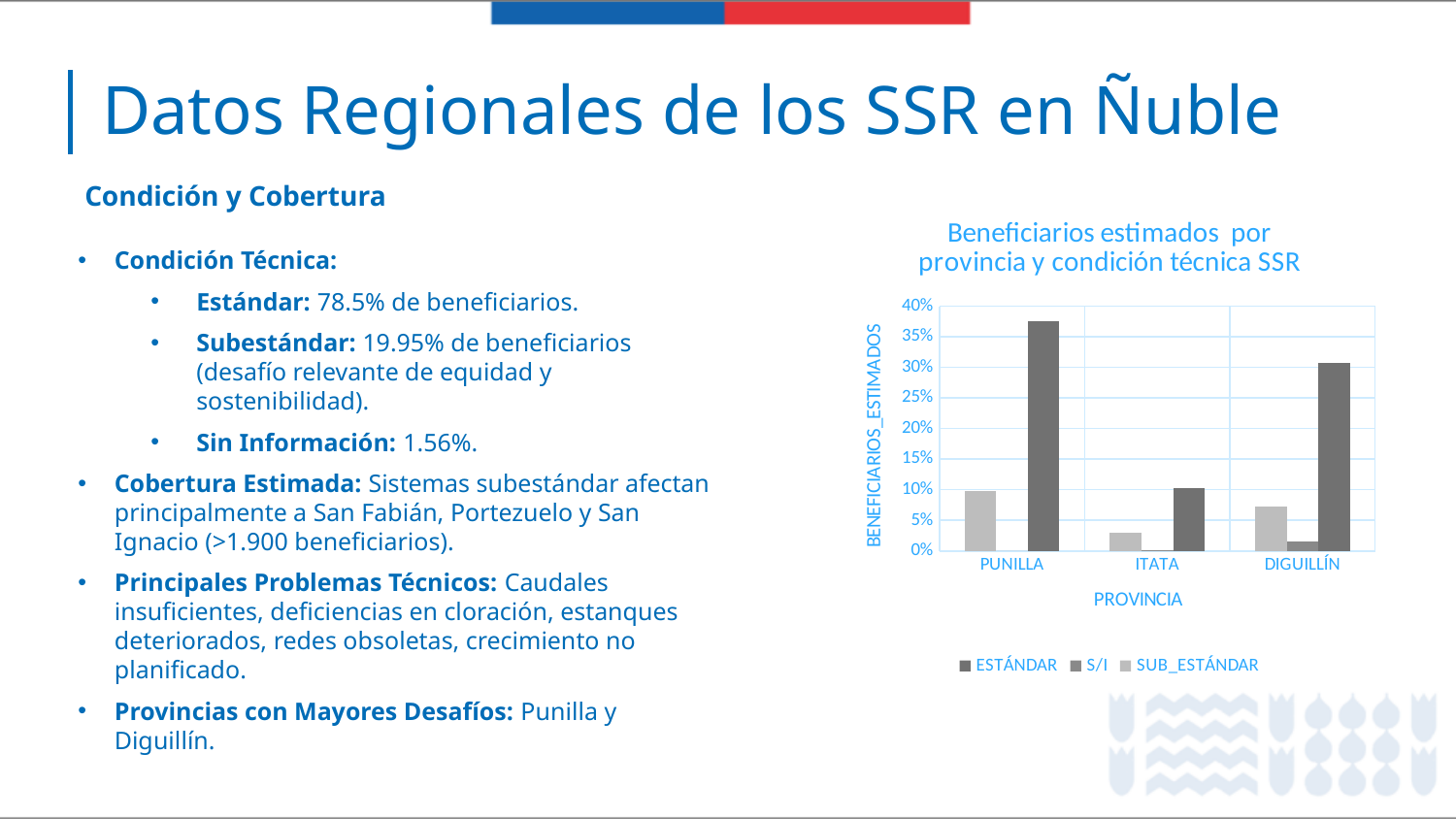
Which province has the lowest ESTÁNDAR value? ITATA How many provinces are shown on the x axis of the chart? 3 How many series does the chart legend list? 3 What is the title of the chart's x axis? PROVINCIA Is the ESTÁNDAR value for DIGUILLÍN greater or less than 25%? greater Which province has the highest ESTÁNDAR value? PUNILLA Is the ESTÁNDAR value for ITATA greater or less than 15%? less What kind of chart is shown on the slide? Bar chart Which province has the lowest SUB_ESTÁNDAR value? ITATA Which is larger, the SUB_ESTÁNDAR value for PUNILLA or for ITATA? PUNILLA Is the ESTÁNDAR value for PUNILLA greater or less than 35%? greater